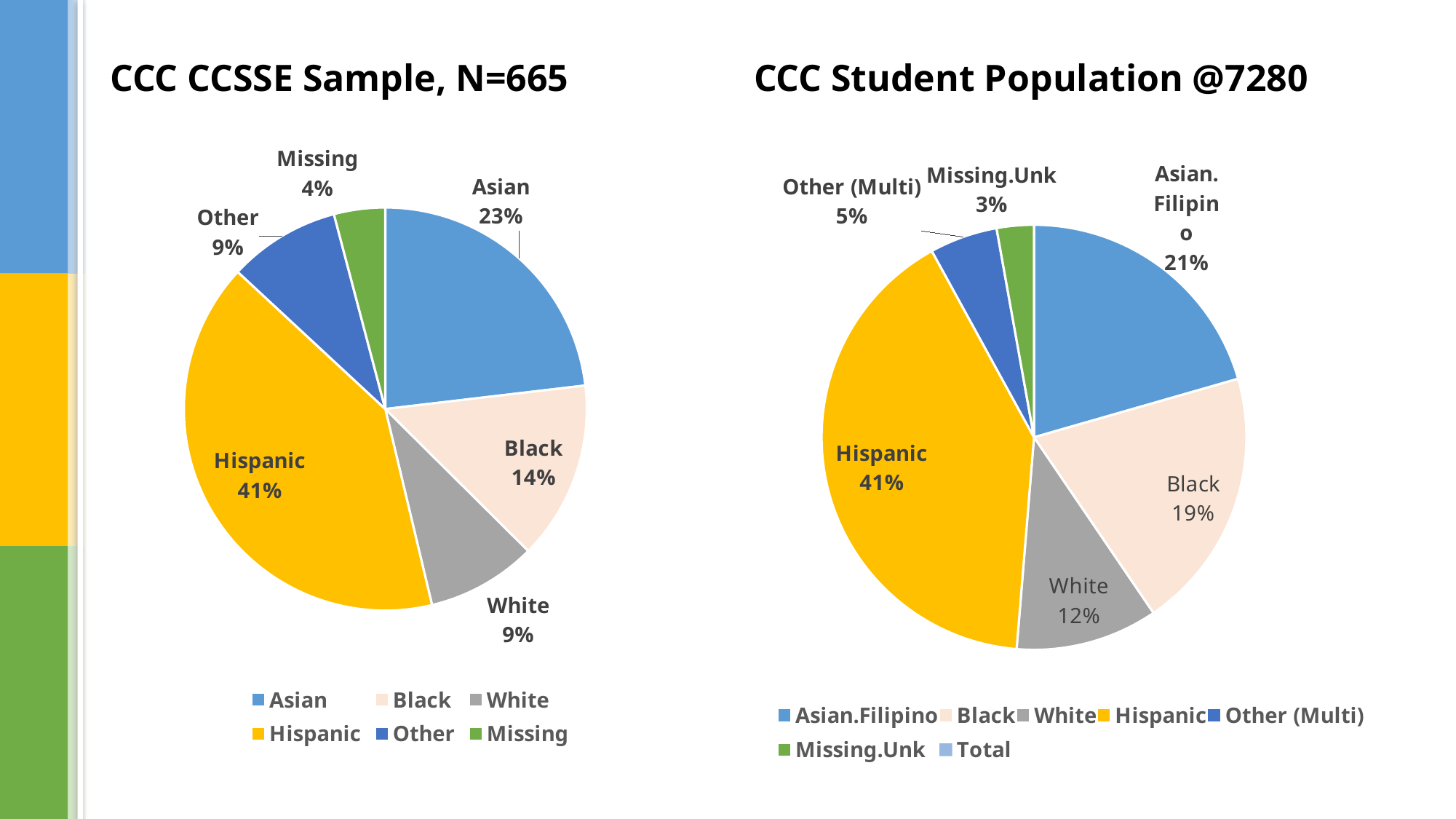
In the 'CCC Student Population @7280' pie chart, what percentage is Asian.Filipino? 21% In the 'CCC CCSSE Sample, N=665' pie chart, what is the difference between the Asian and Black percentages? 9% How many slices does the 'CCC CCSSE Sample, N=665' pie chart have? 6 How many entries does the legend of the 'CCC Student Population @7280' chart list? 7 In the 'CCC CCSSE Sample, N=665' pie chart, what percentage is Hispanic? 41% In the 'CCC Student Population @7280' pie chart, what is the difference between the Black and White percentages? 7% Which is larger in the 'CCC CCSSE Sample, N=665' pie chart: the Asian share or the Black share? Asian In the 'CCC Student Population @7280' pie chart, what percentage is White? 12% In the 'CCC CCSSE Sample, N=665' pie chart, what percentage is Black? 14% In the 'CCC CCSSE Sample, N=665' pie chart, which category has the largest share? Hispanic In the 'CCC Student Population @7280' pie chart, which category has the smallest share? Missing.Unk What type of chart is 'CCC Student Population @7280'? Pie chart